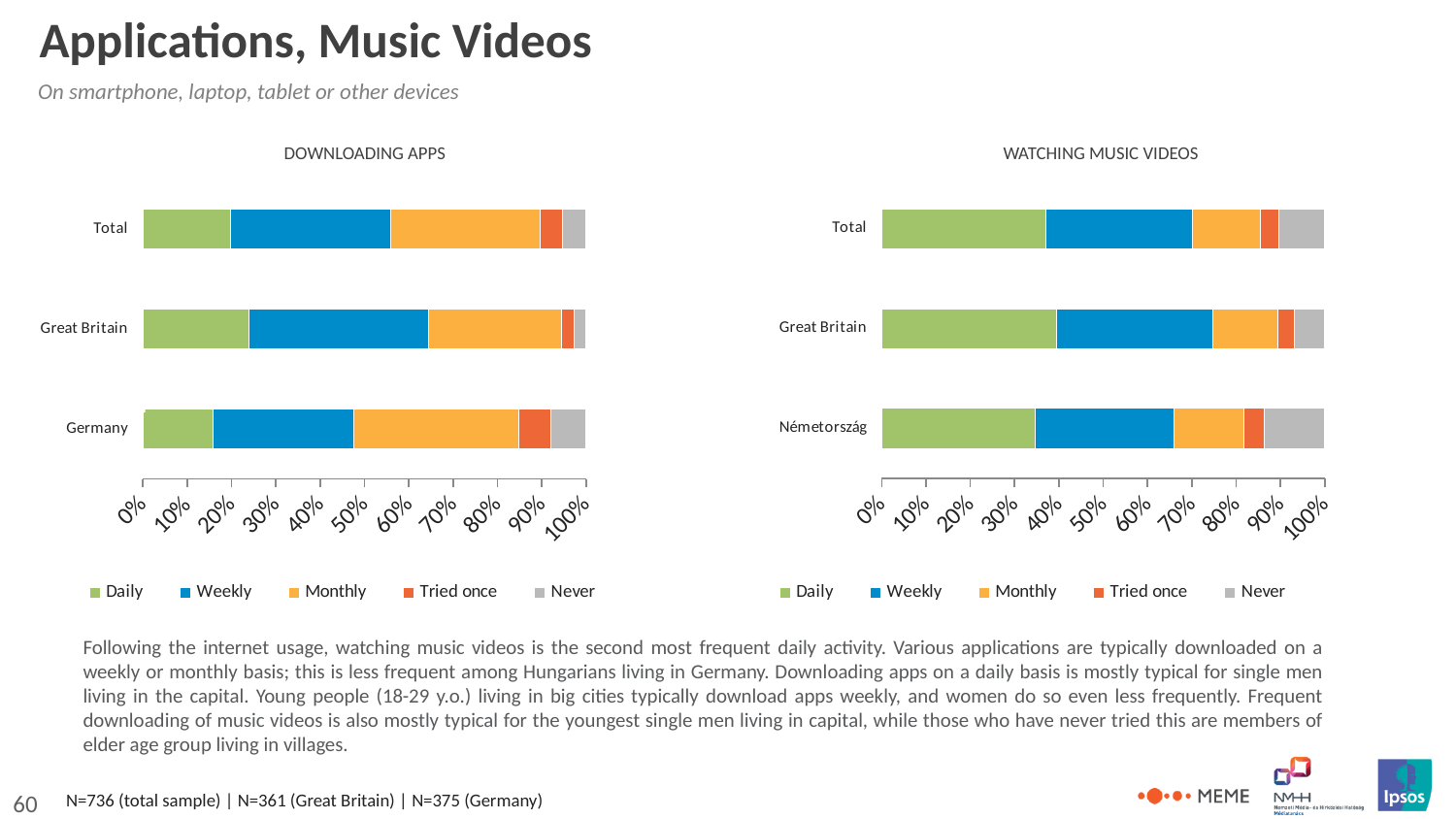
In the DOWNLOADING APPS chart, which category has the largest Never segment? Germany In the DOWNLOADING APPS chart, which category has the largest Daily segment? Great Britain In the WATCHING MUSIC VIDEOS chart, is the Daily value for Total greater or less than 30%? greater In the DOWNLOADING APPS chart, is the Daily value for Germany greater or less than 20%? less In the WATCHING MUSIC VIDEOS chart, which category has the largest Never segment? Németország How many categories are shown on the y axis of the DOWNLOADING APPS chart? 3 What kind of chart is the DOWNLOADING APPS chart? Stacked bar chart In the WATCHING MUSIC VIDEOS chart, is the Never segment larger for Great Britain or for Németország? Németország In the DOWNLOADING APPS chart, is the Daily value for Great Britain greater or less than 20%? greater In the DOWNLOADING APPS chart, which category has the smallest Daily segment? Germany How many series does the legend of the WATCHING MUSIC VIDEOS chart list? 5